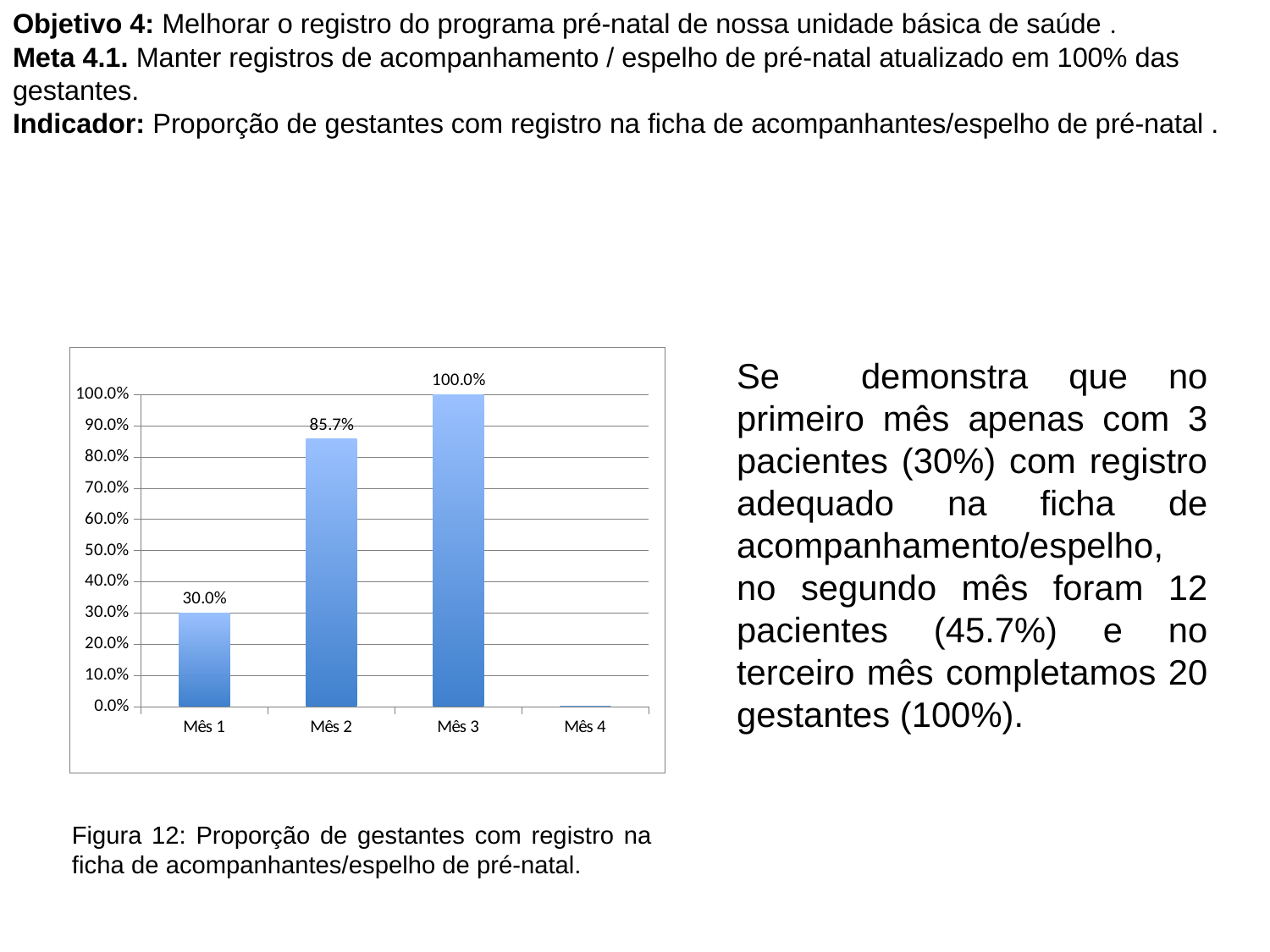
What is the value for Mês 1? 30.0% Is the value for Mês 4 greater or less than 10.0%? less What is the difference between the values for Mês 3 and Mês 1? 70.0% What is the value for Mês 2? 85.7% Do the values rise or fall from Mês 1 to Mês 3? rise Which is larger, the value for Mês 2 or the value for Mês 1? Mês 2 What is the value for Mês 3? 100.0% Which month has the highest value? Mês 3 What kind of chart is shown? bar chart What is the difference between the values for Mês 2 and Mês 1? 55.7% Which month has the lowest value? Mês 4 How many months are shown on the x axis? 4